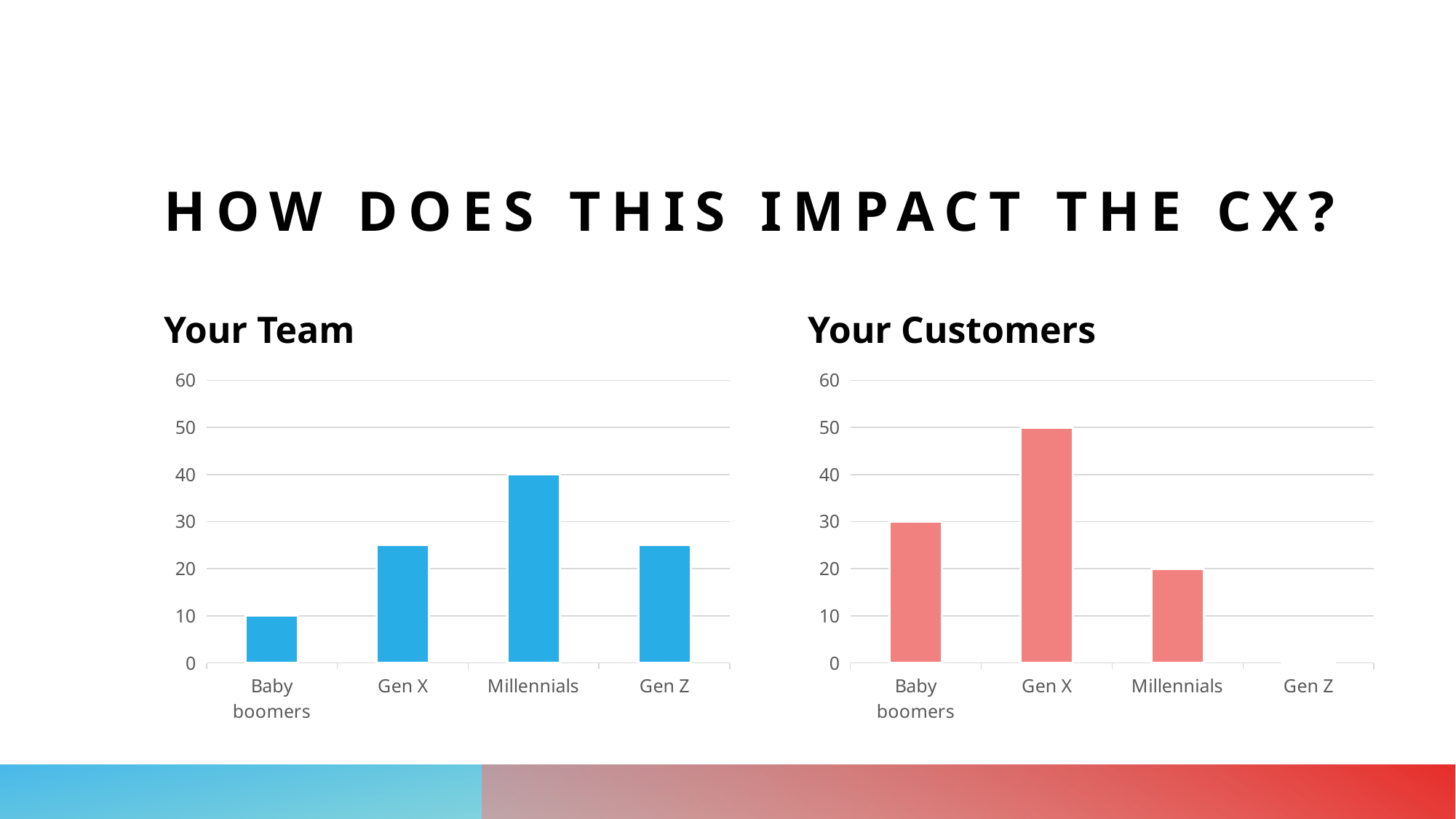
In the "Your Customers" chart, what is the value for Baby boomers? 30 In the "Your Team" chart, what is the value for Baby boomers? 10 In the "Your Team" chart, is the value for Gen Z greater or less than 20? greater In the "Your Team" chart, which category has the lowest value? Baby boomers What type of chart is the "Your Team" chart? bar chart How many categories are shown on the x axis of the "Your Team" chart? 4 In the "Your Customers" chart, which category has the highest value? Gen X In the "Your Team" chart, what is the value for Millennials? 40 In the "Your Team" chart, which category has the highest value? Millennials In the "Your Customers" chart, what is the value for Millennials? 20 In the "Your Customers" chart, what is the value for Gen X? 50 In the "Your Customers" chart, what is the difference between the values for Gen X and Millennials? 30